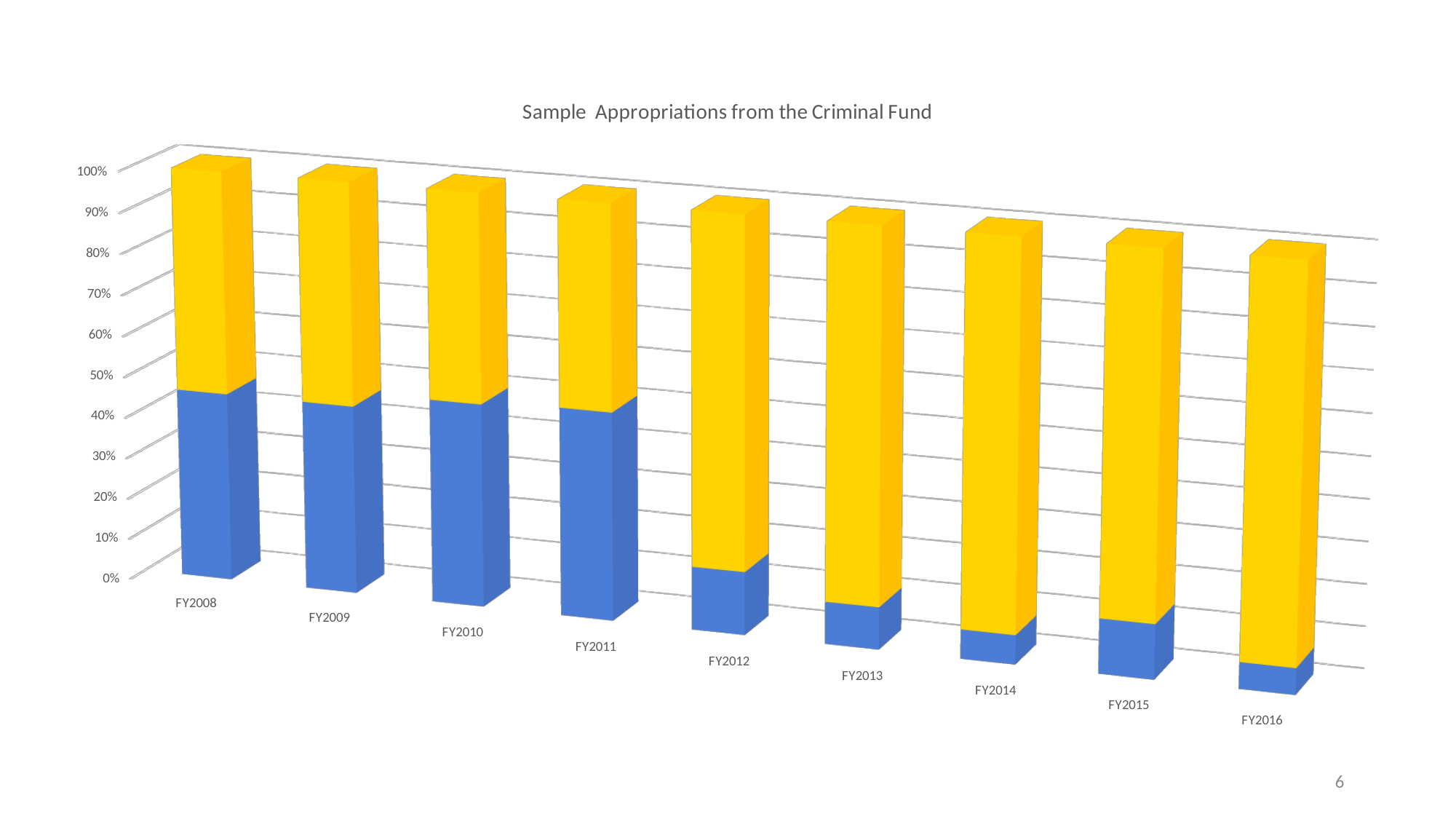
What kind of chart is shown on the slide? stacked bar chart Which has the larger blue segment, FY2011 or FY2015? FY2011 Is the blue segment for FY2011 greater or less than 30%? greater How many fiscal years are shown on the x axis of the chart? 9 Is the blue segment for FY2008 greater or less than 30%? greater Is the blue segment for FY2014 greater or less than 20%? less Which has the larger blue segment, FY2008 or FY2012? FY2008 Which fiscal year is the first category on the x axis? FY2008 What is the title of the chart? Sample Appropriations from the Criminal Fund Does the blue share of the bars rise or fall from FY2008 to FY2016? fall